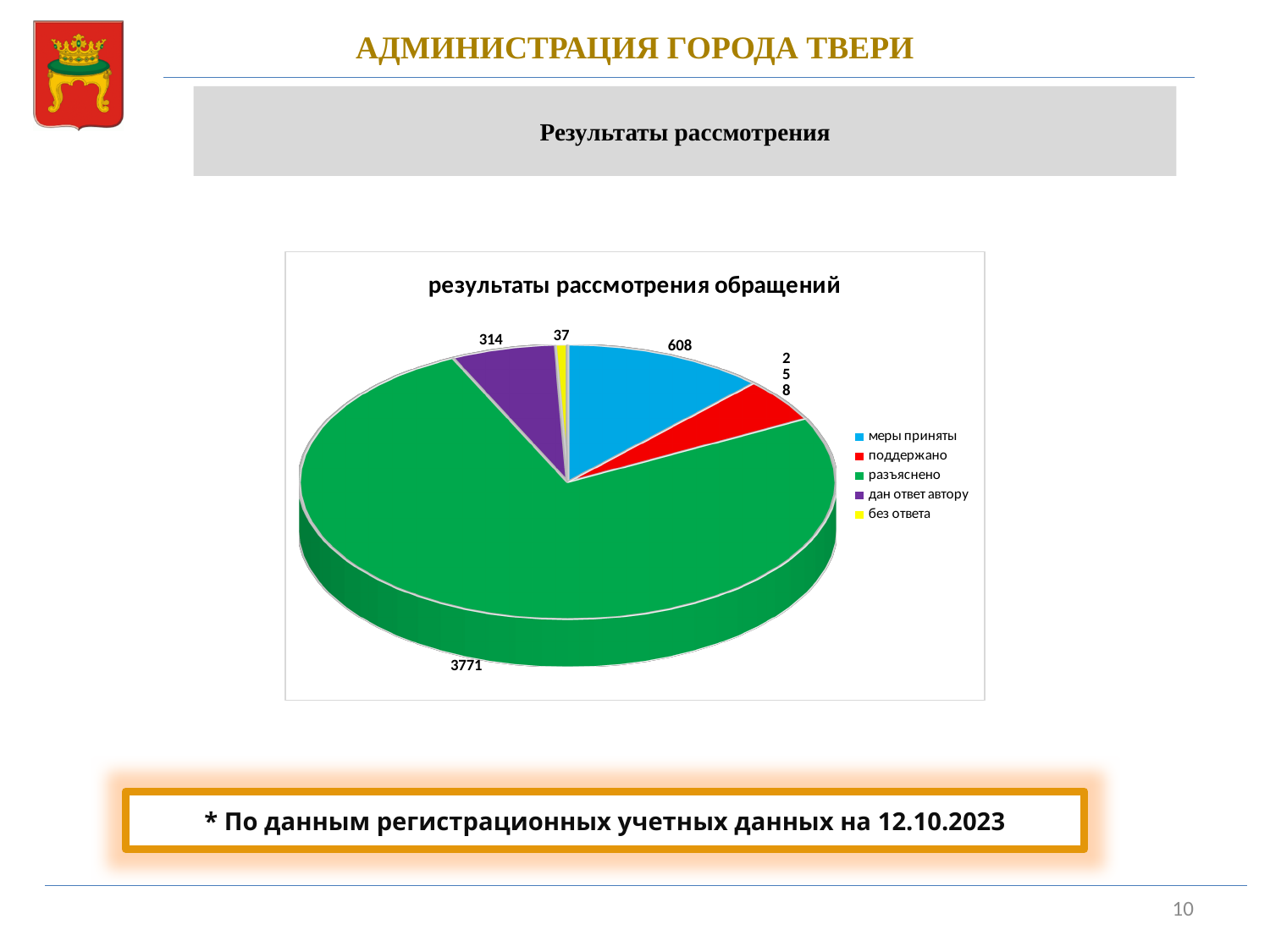
What is the value for "меры приняты" in the pie chart? 608 Which category has the smallest slice in the pie chart? без ответа How many categories does the legend of the pie chart list? 5 Which is larger: the value for "дан ответ автору" or the value for "меры приняты"? меры приняты Which category has the largest slice in the pie chart? разъяснено What is the value for "дан ответ автору" in the pie chart? 314 What is the value for "без ответа" in the pie chart? 37 What is the difference between the values for "меры приняты" and "поддержано"? 350 What is the value for "поддержано" in the pie chart? 258 What type of chart is shown on the slide? pie chart What is the title of the pie chart? результаты рассмотрения обращений What is the value for "разъяснено" in the pie chart? 3771